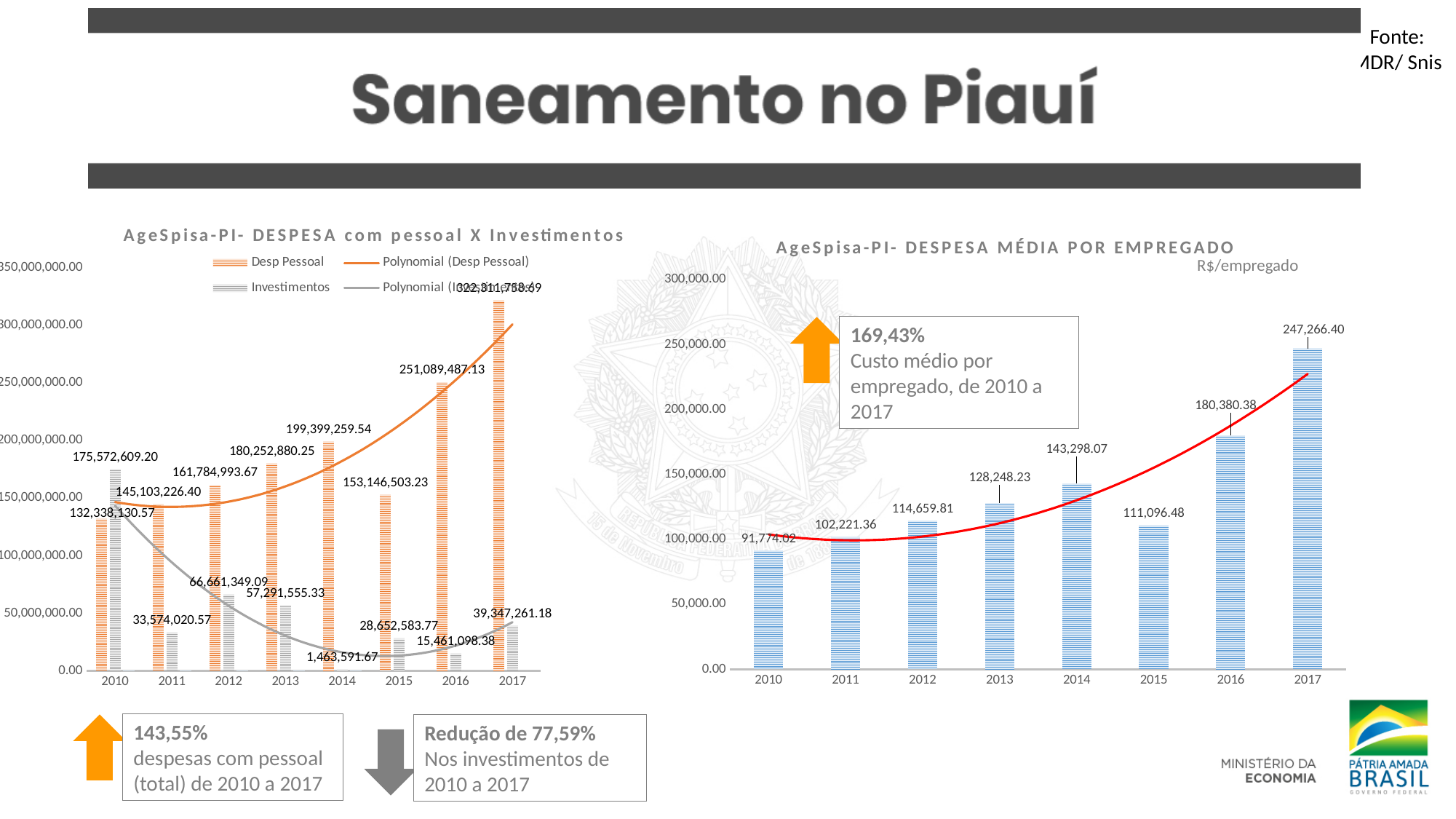
In the 'AgeSpisa-PI- DESPESA com pessoal X Investimentos' chart, what is the Investimentos value for 2014? 1,463,591.67 In the 'AgeSpisa-PI- DESPESA MÉDIA POR EMPREGADO' chart, which year has the larger value, 2014 or 2015? 2014 In the 'AgeSpisa-PI- DESPESA MÉDIA POR EMPREGADO' chart, what is the difference between the 2016 and 2015 values? 69,283.90 In the 'AgeSpisa-PI- DESPESA MÉDIA POR EMPREGADO' chart, which year has the highest value? 2017 What kind of chart is 'AgeSpisa-PI- DESPESA MÉDIA POR EMPREGADO'? bar chart In the 'AgeSpisa-PI- DESPESA MÉDIA POR EMPREGADO' chart, what is the value for 2017? 247,266.40 In the 'AgeSpisa-PI- DESPESA com pessoal X Investimentos' chart, what is the Desp Pessoal value for 2016? 251,089,487.13 How many years are shown on the x axis of the 'AgeSpisa-PI- DESPESA MÉDIA POR EMPREGADO' chart? 8 In the 'AgeSpisa-PI- DESPESA com pessoal X Investimentos' chart, which is larger in 2010, Desp Pessoal or Investimentos? Investimentos In the 'AgeSpisa-PI- DESPESA MÉDIA POR EMPREGADO' chart, which year has the lowest value? 2010 How many entries does the legend of the 'AgeSpisa-PI- DESPESA com pessoal X Investimentos' chart list? 4 In the 'AgeSpisa-PI- DESPESA MÉDIA POR EMPREGADO' chart, is the value for 2013 greater or less than 150,000.00? less